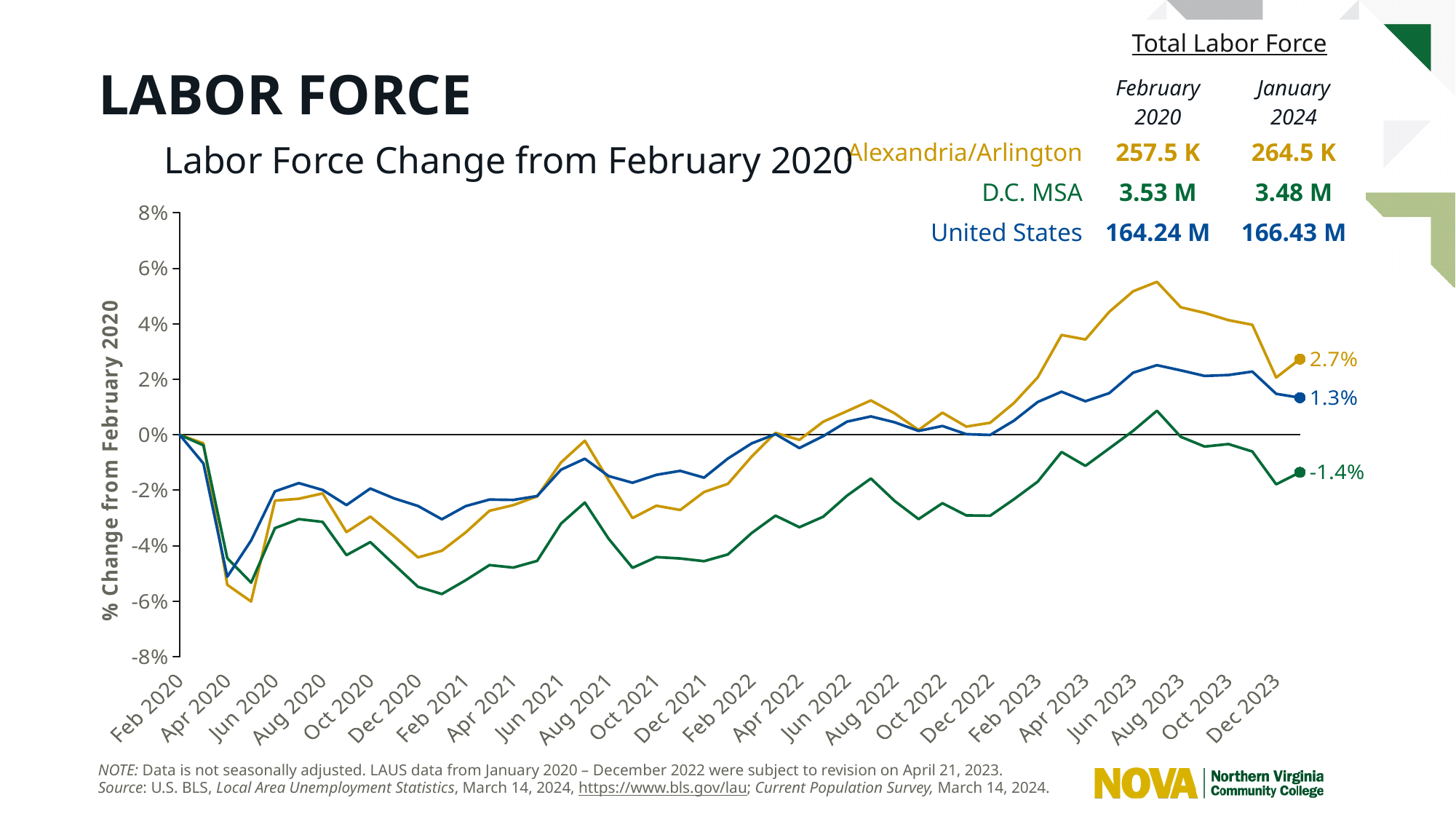
How many series are plotted on the chart? 3 Is the value for D.C. MSA in Feb 2021 greater or less than -4%? less What is the difference between the end-of-chart values for Alexandria/Arlington (2.7%) and United States (1.3%)? 1.4 percentage points What is the labeled value at the end of the Alexandria/Arlington line (Jan 2024)? 2.7% What kind of chart is shown on the slide? line chart Does the Alexandria/Arlington line rise or fall between Aug 2023 and Dec 2023? fall At the end of the chart, which is larger: the United States value or the D.C. MSA value? United States Is the peak value reached by the Alexandria/Arlington line in mid-2023 greater or less than 4%? greater What is the labeled value at the end of the D.C. MSA line (Jan 2024)? -1.4% Which series has the highest value at the end of the chart? Alexandria/Arlington What is the labeled value at the end of the United States line (Jan 2024)? 1.3% Which series has the lowest value at the end of the chart? D.C. MSA